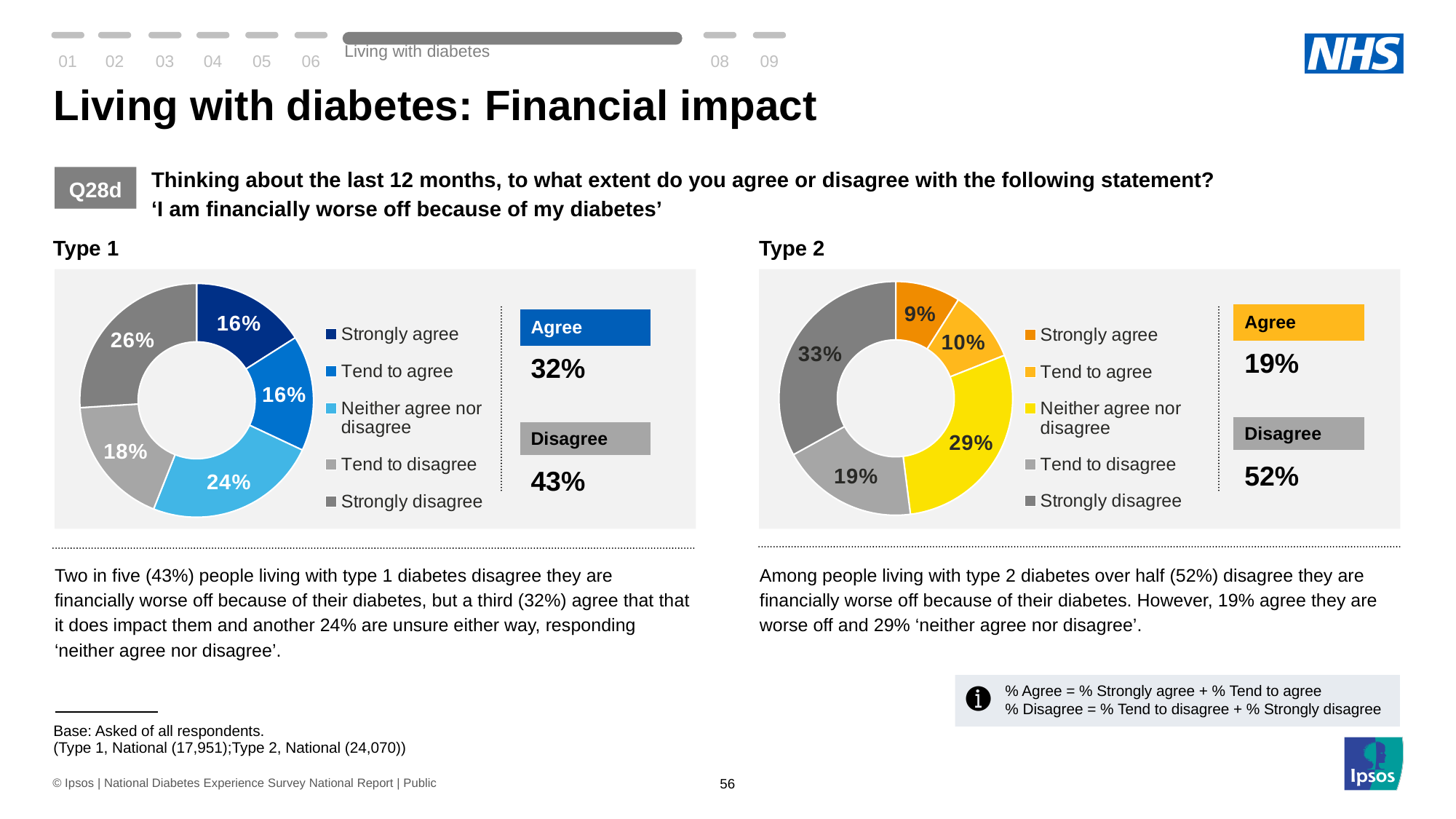
In the Type 2 chart, which is larger: 'Neither agree nor disagree' or 'Tend to disagree'? Neither agree nor disagree In the Type 1 chart, what percentage of respondents said 'Neither agree nor disagree'? 24% In the Type 2 chart, which response category has the largest share? Strongly disagree In the Type 1 chart, which response category has the largest share? Strongly disagree In the Type 1 chart, what is the difference in percentage points between 'Strongly disagree' and 'Tend to disagree'? 8 In the Type 1 chart, what percentage of respondents said 'Strongly disagree'? 26% How many response categories does the legend of the Type 1 chart list? 5 What is the combined 'Disagree' percentage shown next to the Type 2 chart? 52% In the Type 2 chart, which response category has the smallest share? Strongly agree What kind of chart is used to show the Type 2 results? Donut (pie) chart In the Type 2 chart, what percentage of respondents said 'Tend to disagree'? 19% In the Type 2 chart, what percentage of respondents said 'Strongly agree'? 9%